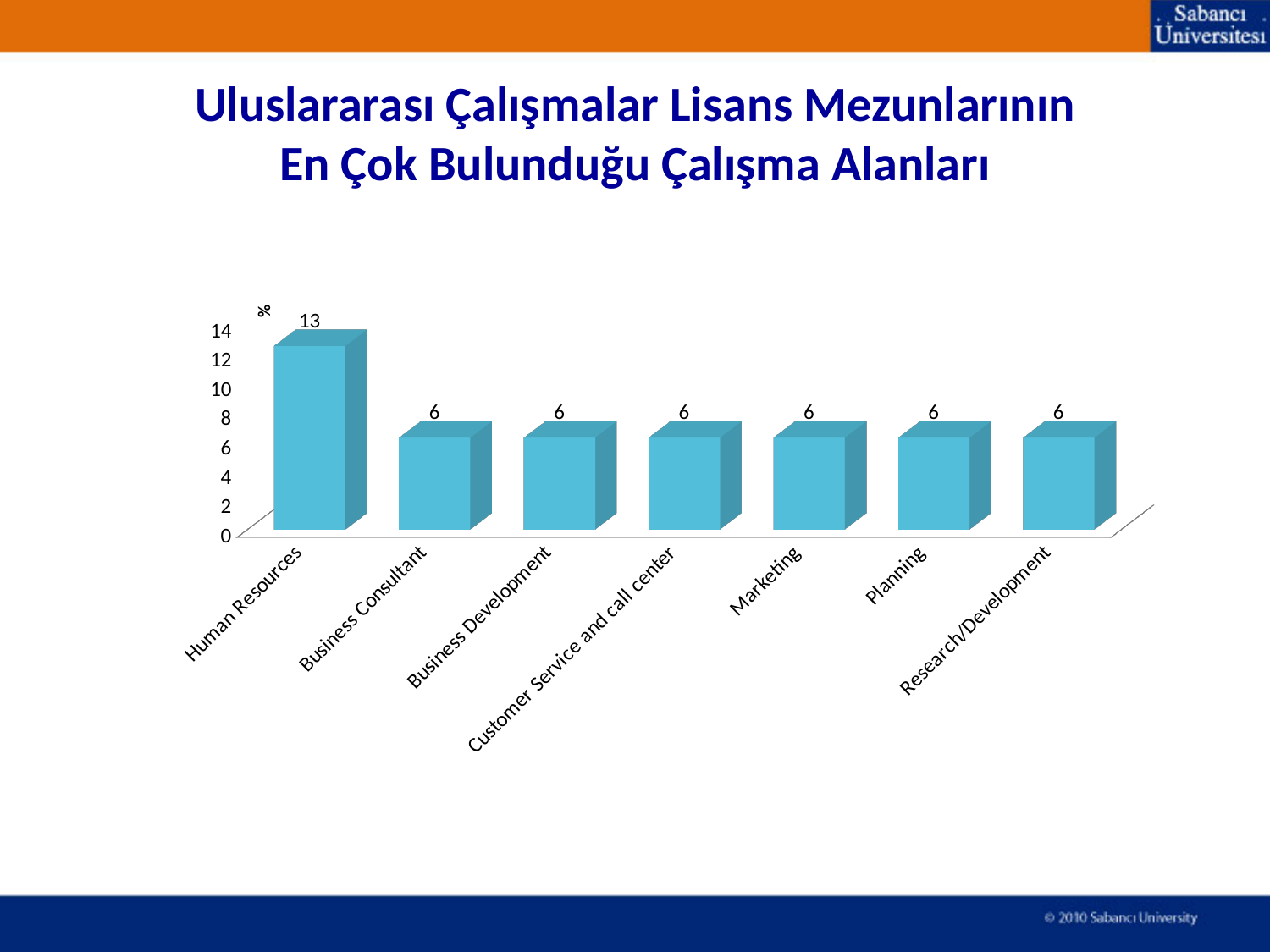
Is the value for Human Resources greater or less than 10? greater What is the value for Marketing? 6 What unit is shown on the vertical axis of the chart? % Which is larger, the value for Human Resources or the value for Planning? Human Resources What kind of chart is shown on the slide? bar chart What is the value for Human Resources? 13 How many categories are shown in the chart? 7 What is the value for Research/Development? 6 How many categories have a value of 6? 6 Which category has the highest value? Human Resources Is the value for Customer Service and call center greater or less than 10? less What is the difference between the values for Human Resources and Business Consultant? 7